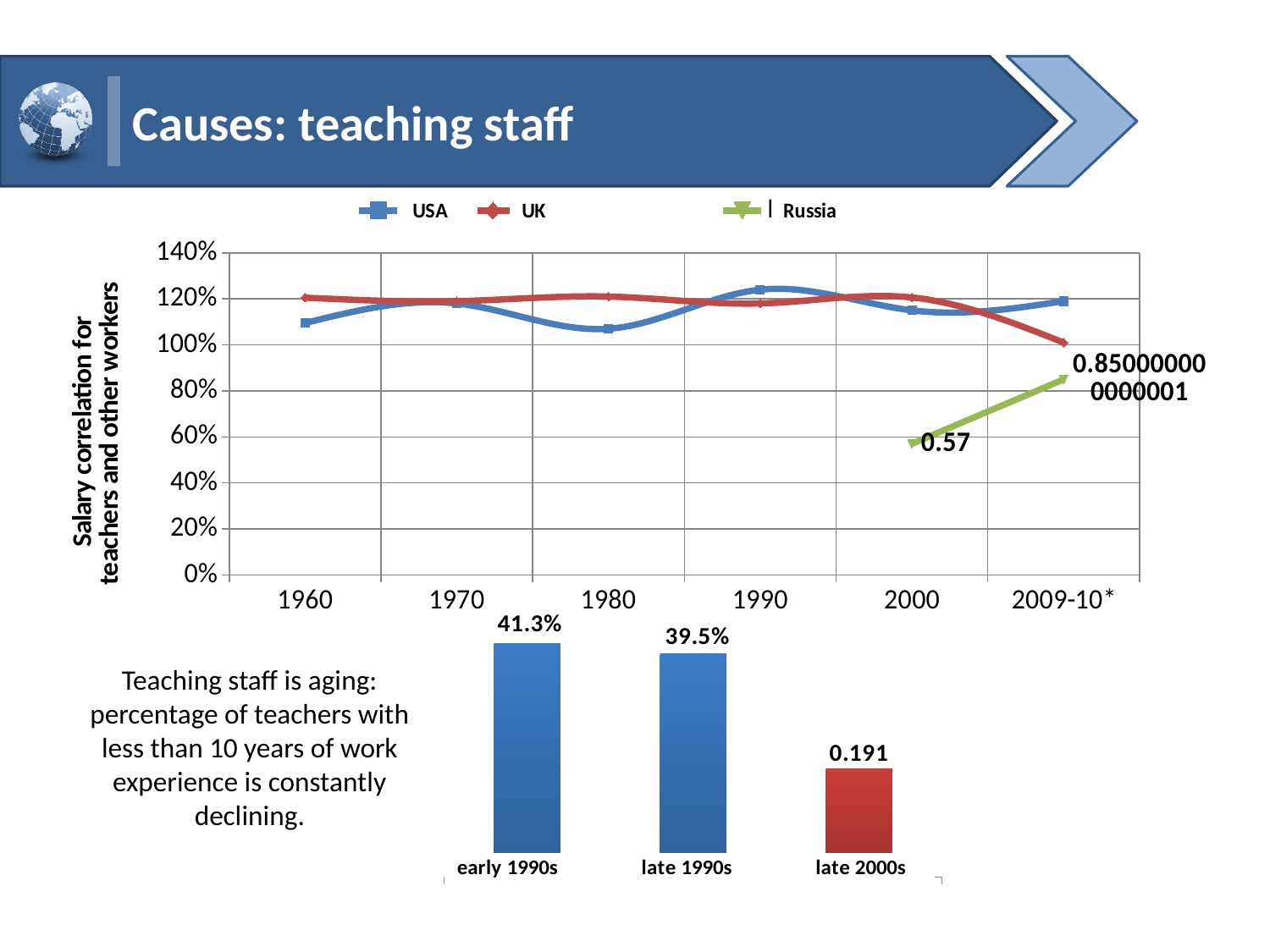
In the bottom bar chart, what is the value for late 1990s? 39.5% What kind of chart is the bottom chart showing early 1990s, late 1990s and late 2000s? bar chart How many series does the legend of the top line chart list? 3 In the bottom bar chart, what is the difference between the early 1990s and late 1990s values? 1.8% In the top line chart, does the Russia series rise or fall from 2000 to 2009-10*? rise In the top line chart, is the value for USA in 1980 greater or less than 100%? greater In the top line chart, is the value for USA in 1960 greater or less than 120%? less In the top line chart, what value is labelled for Russia in 2009-10*? 0.850000000000001 In the bottom bar chart, which category has the highest value? early 1990s In the bottom bar chart, which category has the lowest value? late 2000s In the top line chart, which series is shown in green? Russia In the top line chart, what value is labelled for Russia in 2000? 0.57